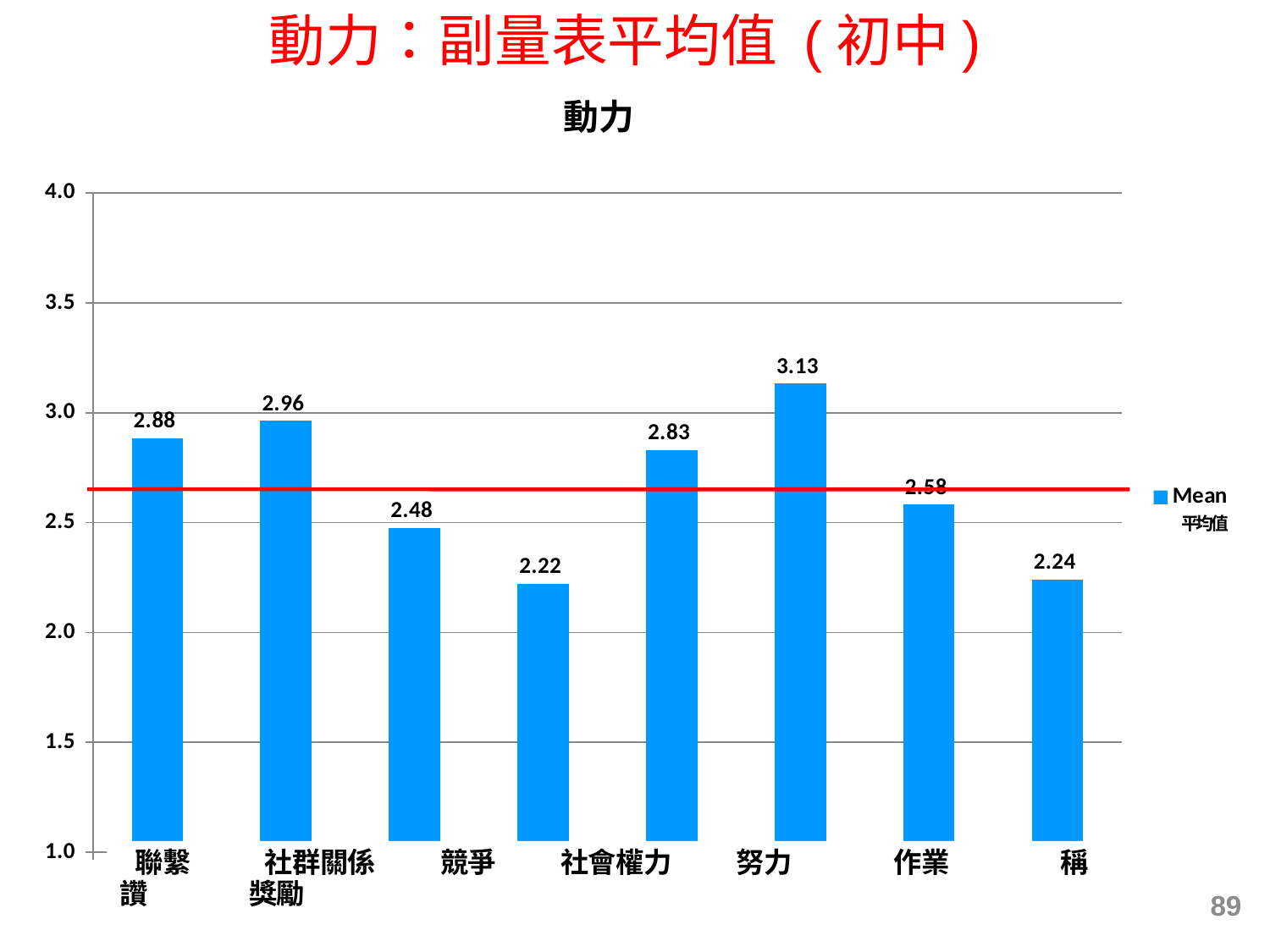
What is the mean value for 努力? 2.83 What is the title of the chart? 動力 What is the mean value for 社會權力? 2.22 How many series does the legend list? 1 Which category has the highest mean value? 作業 Which category has the lowest mean value? 社會權力 What is the mean value for 作業? 3.13 What is the difference between the mean values for 努力 and 社會權力? 0.61 How many categories are shown on the x axis? 8 What type of chart is shown on the slide? bar chart